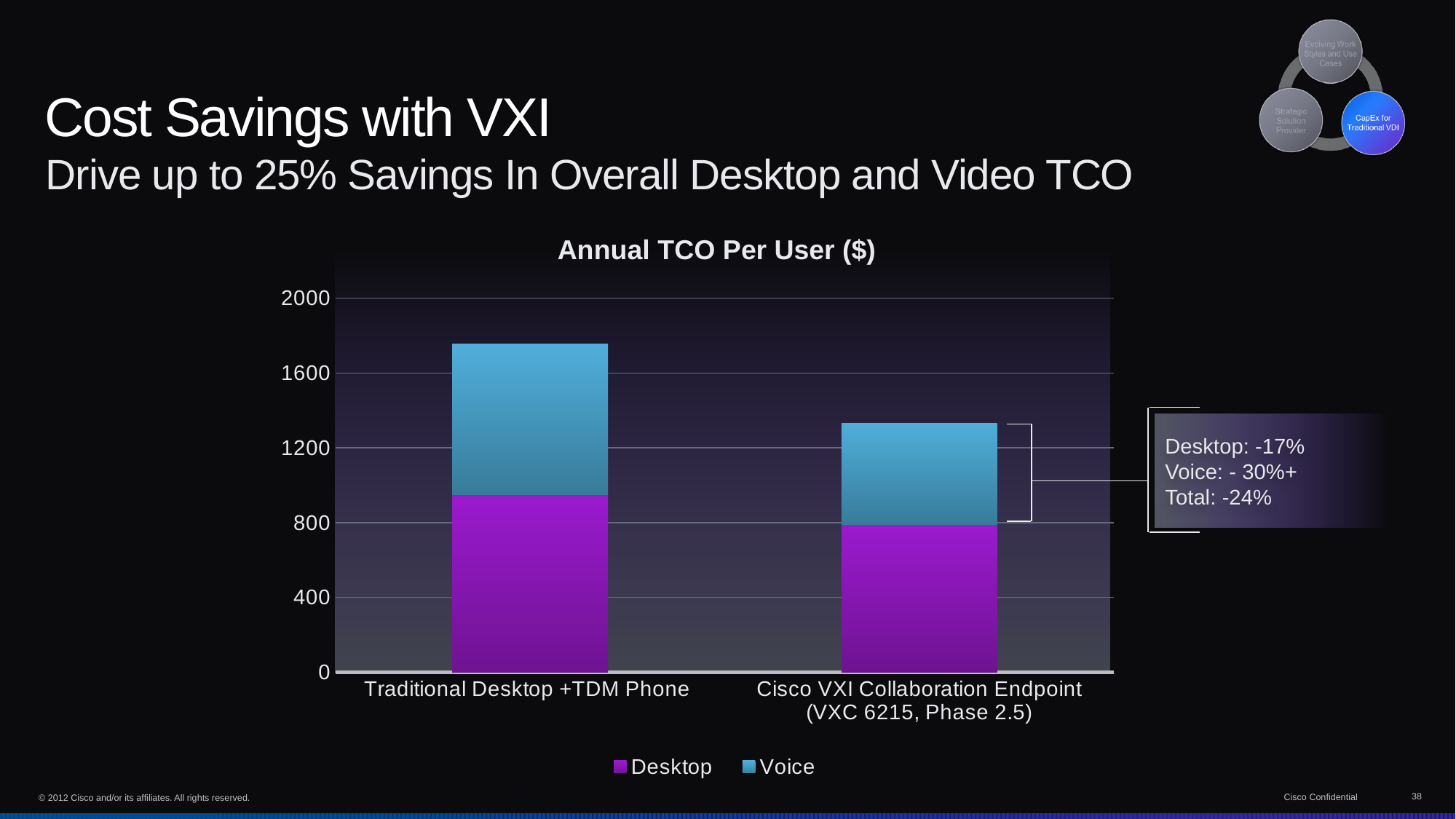
According to the callout next to the chart, what is the total percentage change in TCO? -24% Is the total value for Cisco VXI Collaboration Endpoint (VXC 6215, Phase 2.5) greater or less than 1600? less How many series does the legend list? 2 Is the Desktop segment larger for Traditional Desktop +TDM Phone or for Cisco VXI Collaboration Endpoint? Traditional Desktop +TDM Phone Which category has the higher total annual TCO per user? Traditional Desktop +TDM Phone Is the Voice segment larger for Traditional Desktop +TDM Phone or for Cisco VXI Collaboration Endpoint? Traditional Desktop +TDM Phone What is the title of the chart? Annual TCO Per User ($) How many categories are shown on the x axis? 2 What kind of chart is shown on the slide? Stacked bar chart Is the Desktop value for Traditional Desktop +TDM Phone greater or less than 800? greater Is the total value for Traditional Desktop +TDM Phone greater or less than 1600? greater Which category has the lower total annual TCO per user? Cisco VXI Collaboration Endpoint (VXC 6215, Phase 2.5)